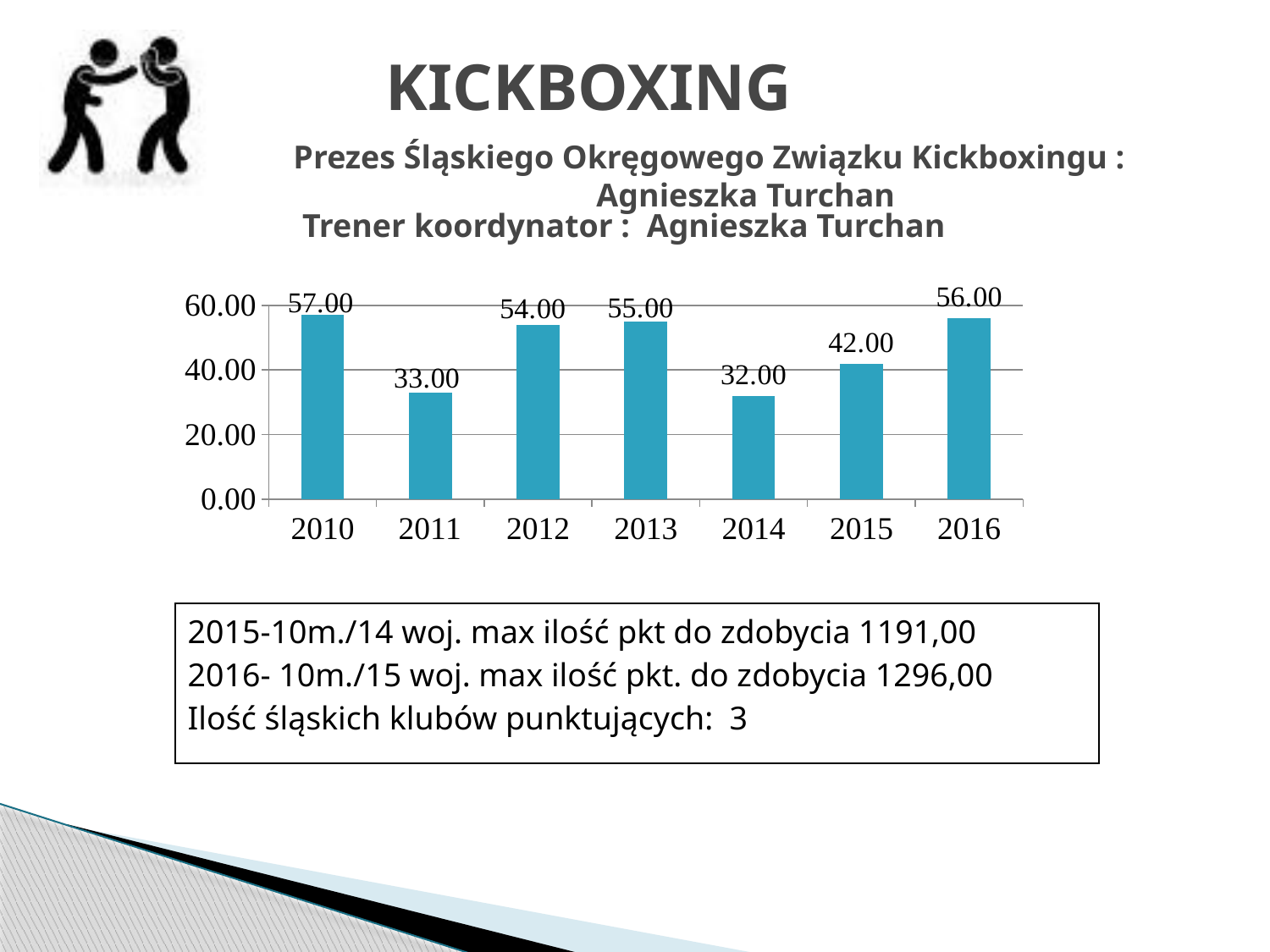
What is the value for 2016? 56.00 Which year has the highest value? 2010 Which year has the lowest value? 2014 What is the difference between the values for 2013 and 2011? 22.00 What kind of chart is shown on the slide? bar chart Is the value for 2015 greater or less than 40.00? greater What is the difference between the values for 2016 and 2015? 14.00 What is the value for 2010? 57.00 Does the value rise or fall from 2014 to 2016? rise How many years are shown on the x axis? 7 What is the value for 2014? 32.00 Which is larger, the value for 2012 or the value for 2015? 2012